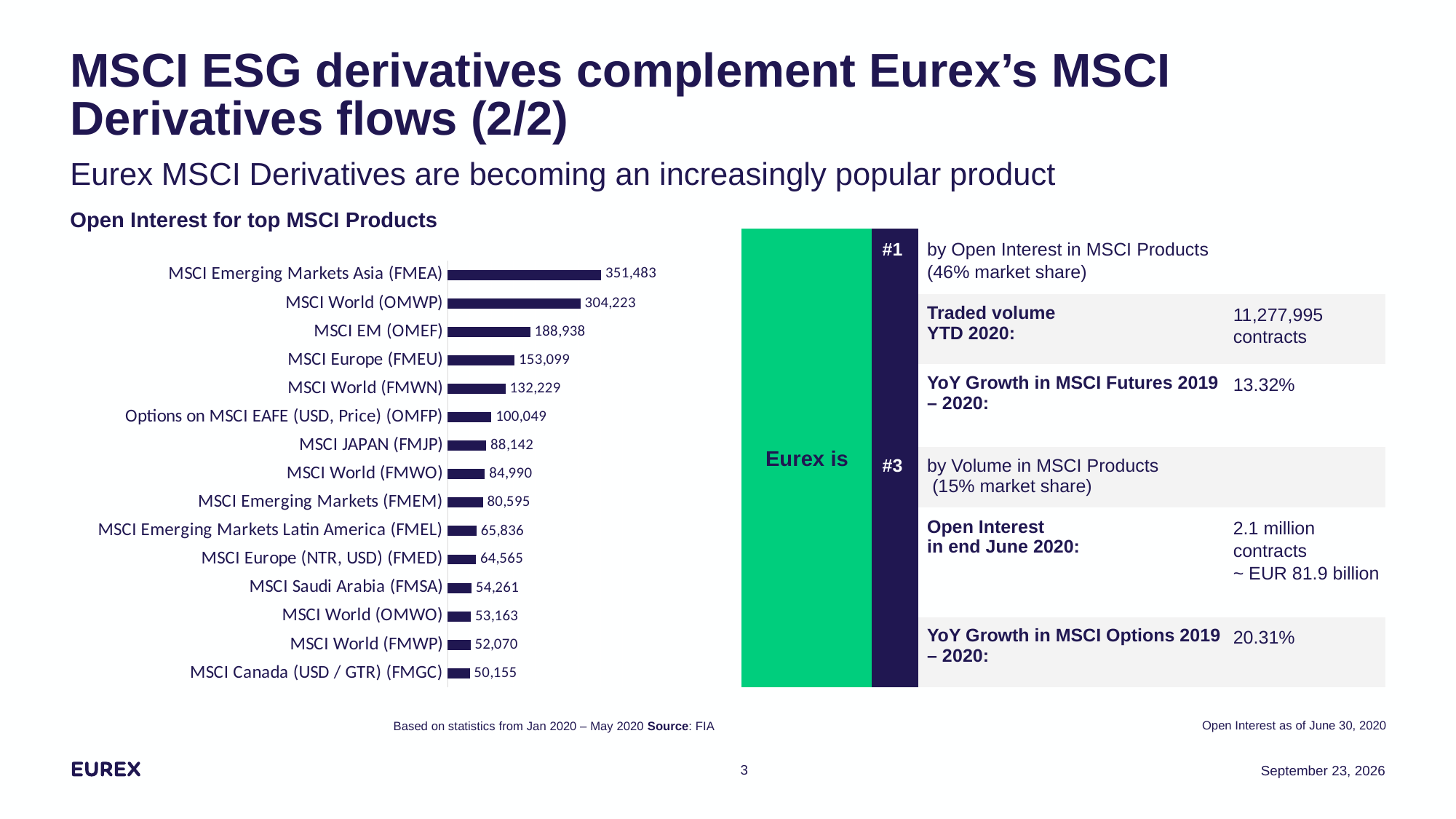
Which has a larger open interest, MSCI JAPAN (FMJP) or MSCI World (FMWO)? MSCI JAPAN (FMJP) Which product has the lowest open interest? MSCI Canada (USD / GTR) (FMGC) What is the open interest for MSCI Europe (FMEU)? 153,099 What kind of chart is used to show open interest for top MSCI products? Bar chart What is the title of the chart? Open Interest for top MSCI Products Which product has the highest open interest? MSCI Emerging Markets Asia (FMEA) What is the difference in open interest between MSCI EM (OMEF) and MSCI World (FMWN)? 56,709 What is the open interest for MSCI Emerging Markets Asia (FMEA)? 351,483 What is the difference in open interest between MSCI Emerging Markets Asia (FMEA) and MSCI World (OMWP)? 47,260 How many products are shown in the chart? 15 Which has a larger open interest, Options on MSCI EAFE (USD, Price) (OMFP) or MSCI Emerging Markets (FMEM)? Options on MSCI EAFE (USD, Price) (OMFP) What is the open interest for MSCI Saudi Arabia (FMSA)? 54,261